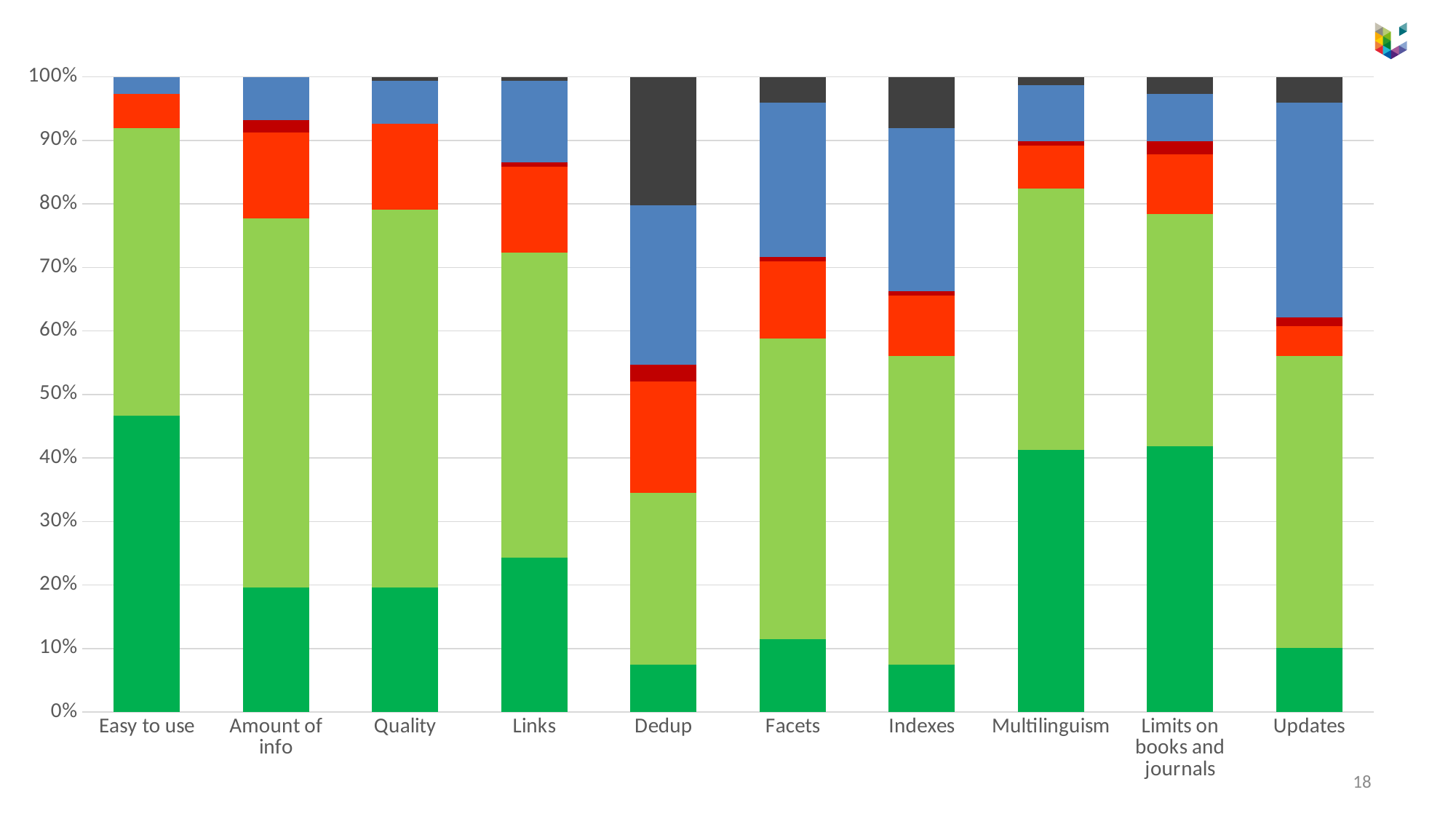
Is the bottom (dark green) segment for Links greater or less than 20%? greater How many categories are shown along the x axis? 10 Which has a larger bottom (dark green) segment, Easy to use or Dedup? Easy to use Is the bottom (dark green) segment for Indexes greater or less than 10%? less Is the bottom (dark green) segment for Dedup greater or less than 10%? less Which category has the largest bottom (dark green) segment? Easy to use Which category has the largest dark gray (top) segment? Dedup What kind of chart is shown on the slide? Stacked bar chart What is the total height of the stacked bar for Easy to use? 100% What colour is the bottom segment of each stacked bar? Dark green